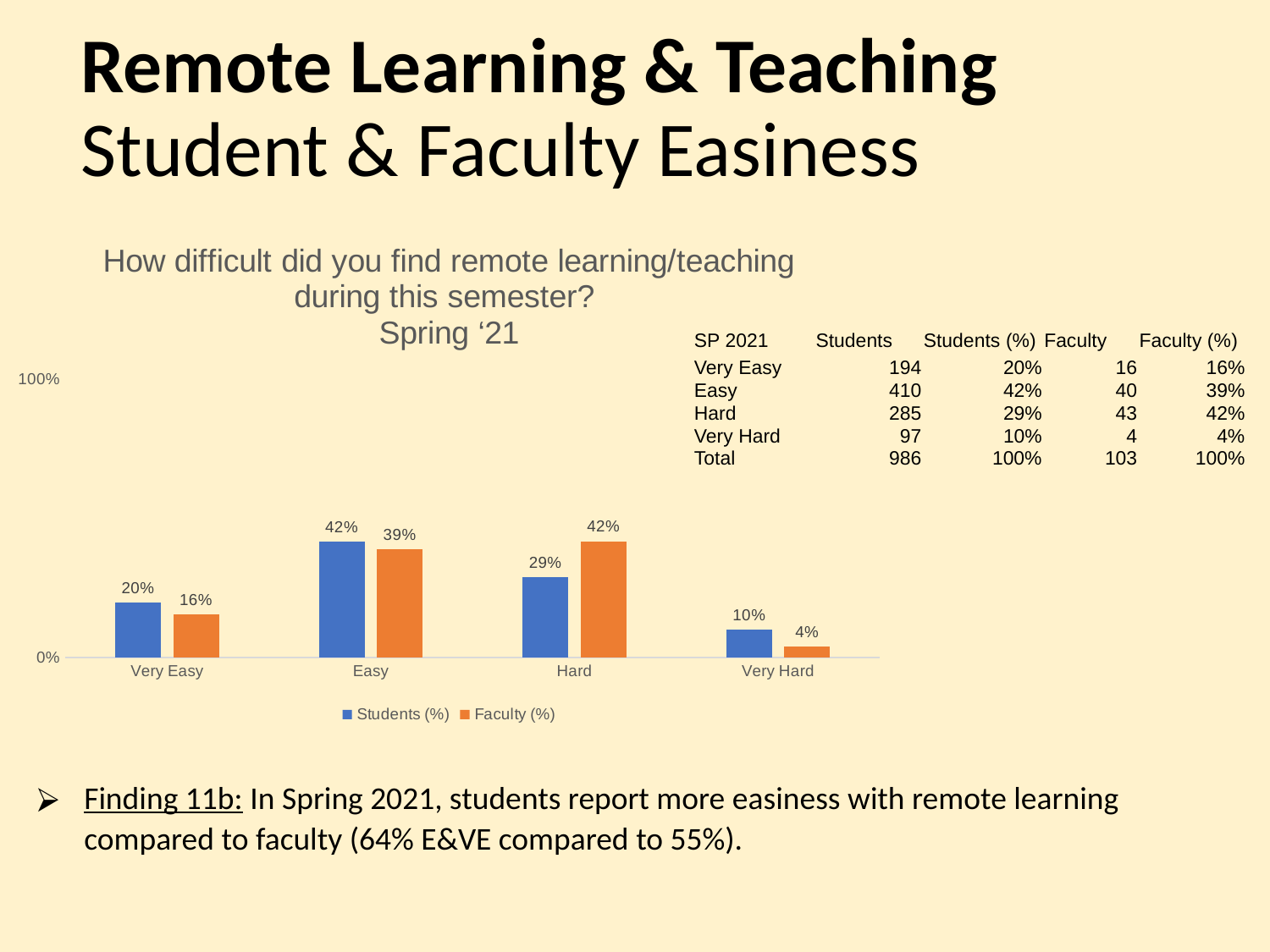
Which colour represents the Faculty (%) series? Orange What is the Students (%) value for Very Easy? 20% What is the Faculty (%) value for Hard? 42% How many categories are shown on the x axis? 4 Which category has the highest Students (%) value? Easy What kind of chart is shown? Bar chart What is the Students (%) value for Easy? 42% What is the difference between the Students (%) and Faculty (%) values for Hard? 13% Which category has the lowest Faculty (%) value? Very Hard How many series does the legend list? 2 What is the Faculty (%) value for Very Hard? 4% Which is larger for Very Easy: Students (%) or Faculty (%)? Students (%)